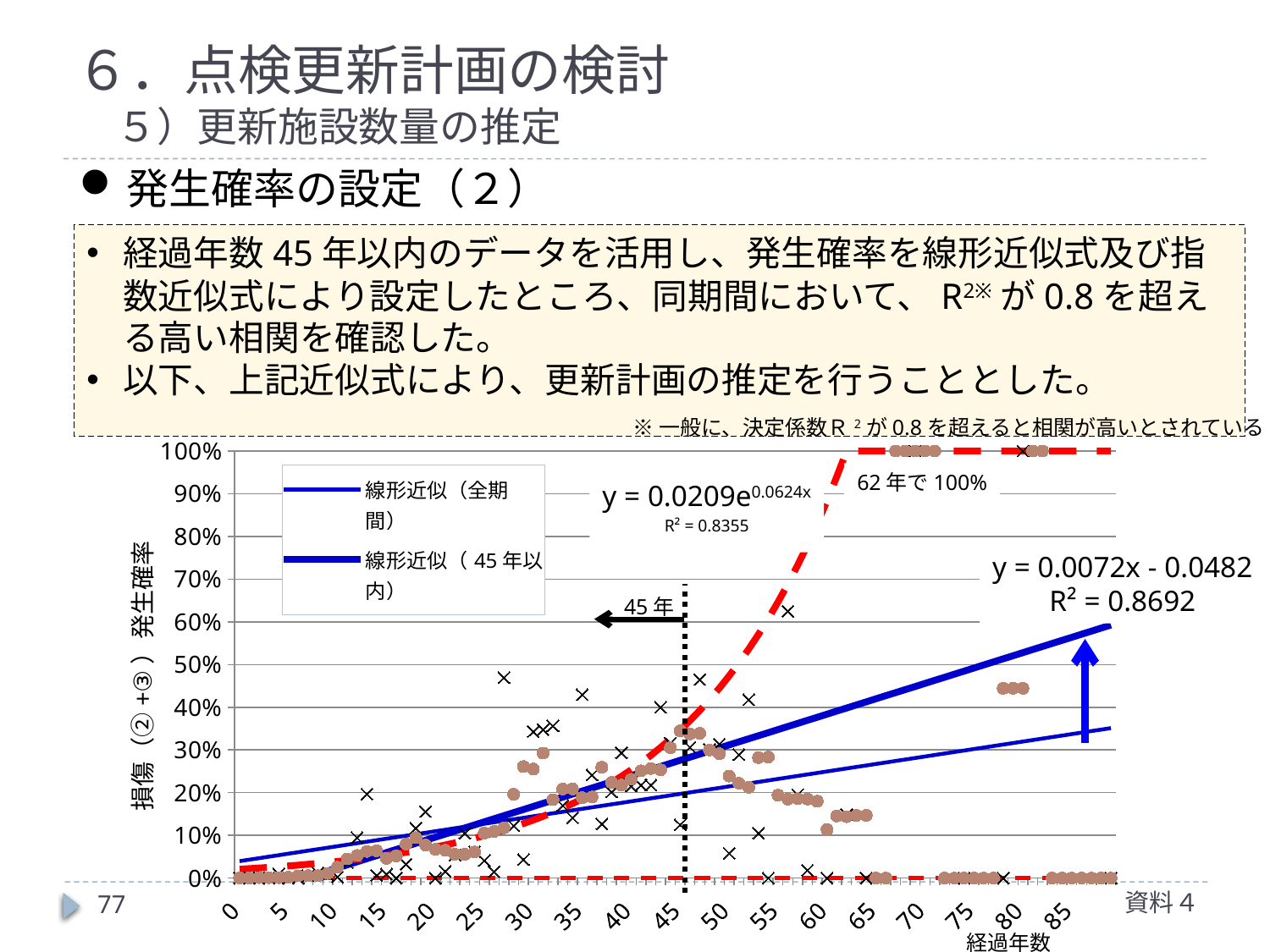
At what value of 経過年数 is the vertical dotted line drawn on the chart? 45年 What is the R² value shown for the linear approximation y = 0.0072x - 0.0482? 0.8692 What kind of chart is shown on the slide? Line chart According to the annotation on the chart, at how many years does the exponential curve reach 100%? 62年 What are the two entries in the chart legend? 線形近似（全期間）, 線形近似（45年以内） Which approximation has the higher R² value, the exponential fit or the linear fit (45年以内)? Linear fit (R² = 0.8692) How many series does the chart legend list? 2 What is the difference between the two R² values shown on the chart (0.8692 and 0.8355)? 0.0337 Do the trend lines on the chart rise or fall as 経過年数 increases? Rise What is the label of the x axis of the chart? 経過年数 What is the R² value shown for the exponential approximation y = 0.0209e^0.0624x? 0.8355 What is the equation of the linear approximation shown on the chart? y = 0.0072x - 0.0482